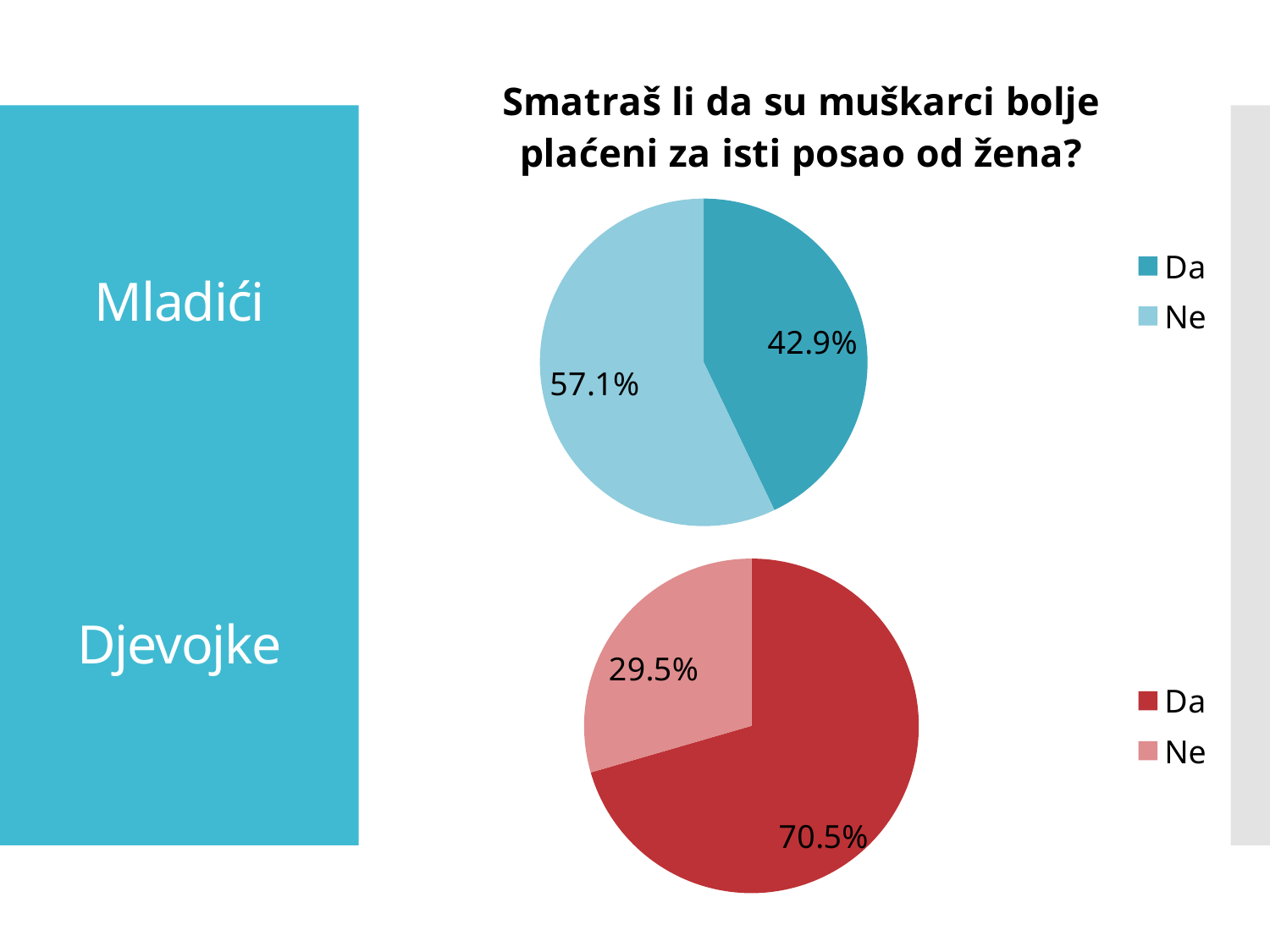
In the bottom pie chart (Djevojke), what percentage answered "Da"? 70.5% In the top pie chart (Mladići), which answer has the larger share? Ne What is the title of the chart on the slide? Smatraš li da su muškarci bolje plaćeni za isti posao od žena? How many slices does the bottom pie chart (Djevojke) have? 2 Is the "Da" share larger in the top pie chart (Mladići) or the bottom pie chart (Djevojke)? Bottom (Djevojke) What type of chart is used on this slide? Pie chart In the bottom pie chart (Djevojke), which answer has the smaller share? Ne In the top pie chart (Mladići), what is the difference between the "Ne" and "Da" shares? 14.2% In the top pie chart (Mladići), what percentage answered "Da"? 42.9% In the bottom pie chart (Djevojke), what percentage answered "Ne"? 29.5% In the top pie chart (Mladići), what percentage answered "Ne"? 57.1% In the bottom pie chart (Djevojke), what is the difference between the "Da" and "Ne" shares? 41.0%